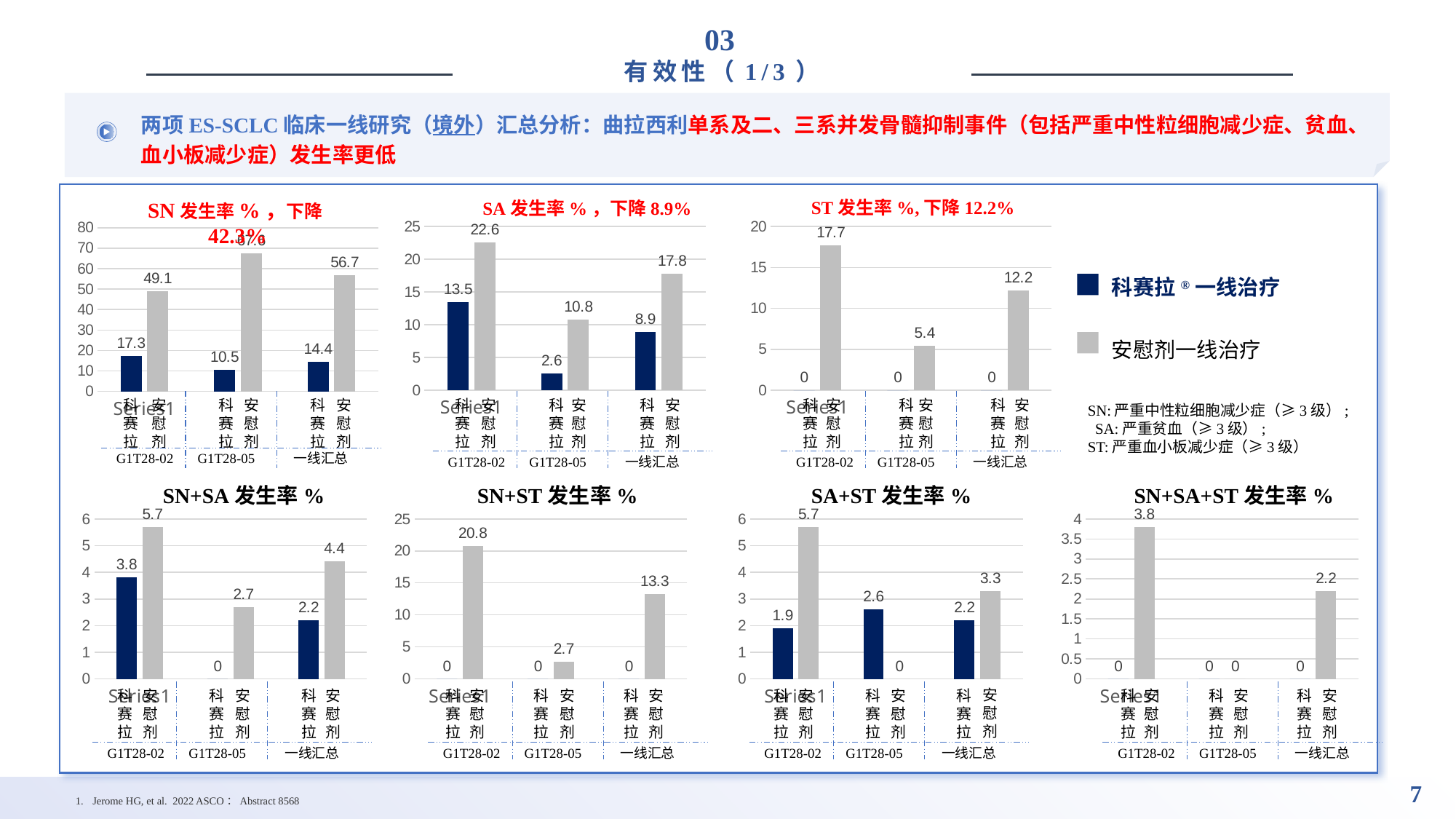
Which colour represents 安慰剂一线治疗 in the legend? grey In the "ST 发生率 %" chart, what is the value for 安慰剂 in G1T28-05? 5.4 In the "SN 发生率 %" chart, what is the value for 科赛拉 in the 一线汇总 group? 14.4 In the "SN 发生率 %" chart, is the value for 安慰剂 in G1T28-05 greater or less than 60? greater In the "SA+ST 发生率 %" chart, which is larger in G1T28-05: 科赛拉 or 安慰剂? 科赛拉 What type of chart is the "SN+SA+ST 发生率 %" chart? bar chart In the "SA 发生率 %" chart, what is the value for 安慰剂 in G1T28-02? 22.6 How many series does the legend on the slide list? 2 In the "SN+SA+ST 发生率 %" chart, what is the value for 安慰剂 in the 一线汇总 group? 2.2 How many study groups are shown on the x axis of the "SN+ST 发生率 %" chart? 3 In the "SA 发生率 %" chart, what is the difference between the 安慰剂 and 科赛拉 values in the 一线汇总 group? 8.9 In the "SN+SA 发生率 %" chart, which bar is the highest? 安慰剂 in G1T28-02